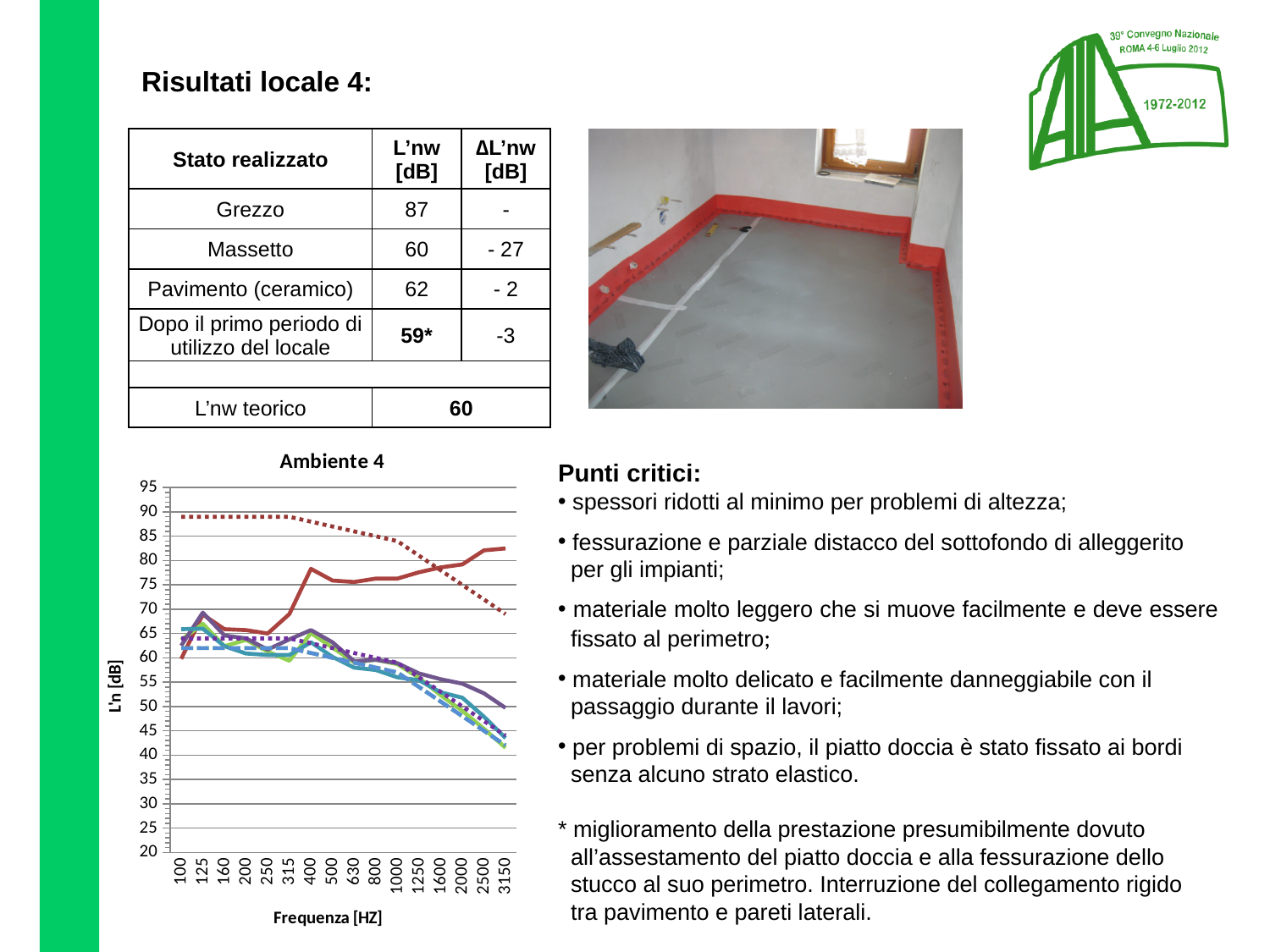
How many frequency values are shown on the x axis of the "Ambiente 4" chart? 16 What is the x-axis title of the "Ambiente 4" chart? Frequenza [HZ] In the "Ambiente 4" chart, is the value of the solid red line at 3150 Hz greater or less than 80? greater What kind of chart is the "Ambiente 4" chart? line chart In the "Ambiente 4" chart, does the solid red line rise or fall from 100 Hz to 3150 Hz? rise In the "Ambiente 4" chart, is the value of the blue dashed line at 3150 Hz greater or less than 45? less What is the title of the chart on the slide? Ambiente 4 In the "Ambiente 4" chart, is the value of the red dotted line at 100 Hz greater or less than 85? greater In the "Ambiente 4" chart, at 100 Hz, which is larger: the red dotted line or the solid red line? the red dotted line What is the highest value shown on the y axis of the "Ambiente 4" chart? 95 In the "Ambiente 4" chart, does the red dotted line rise or fall from 100 Hz to 3150 Hz? fall